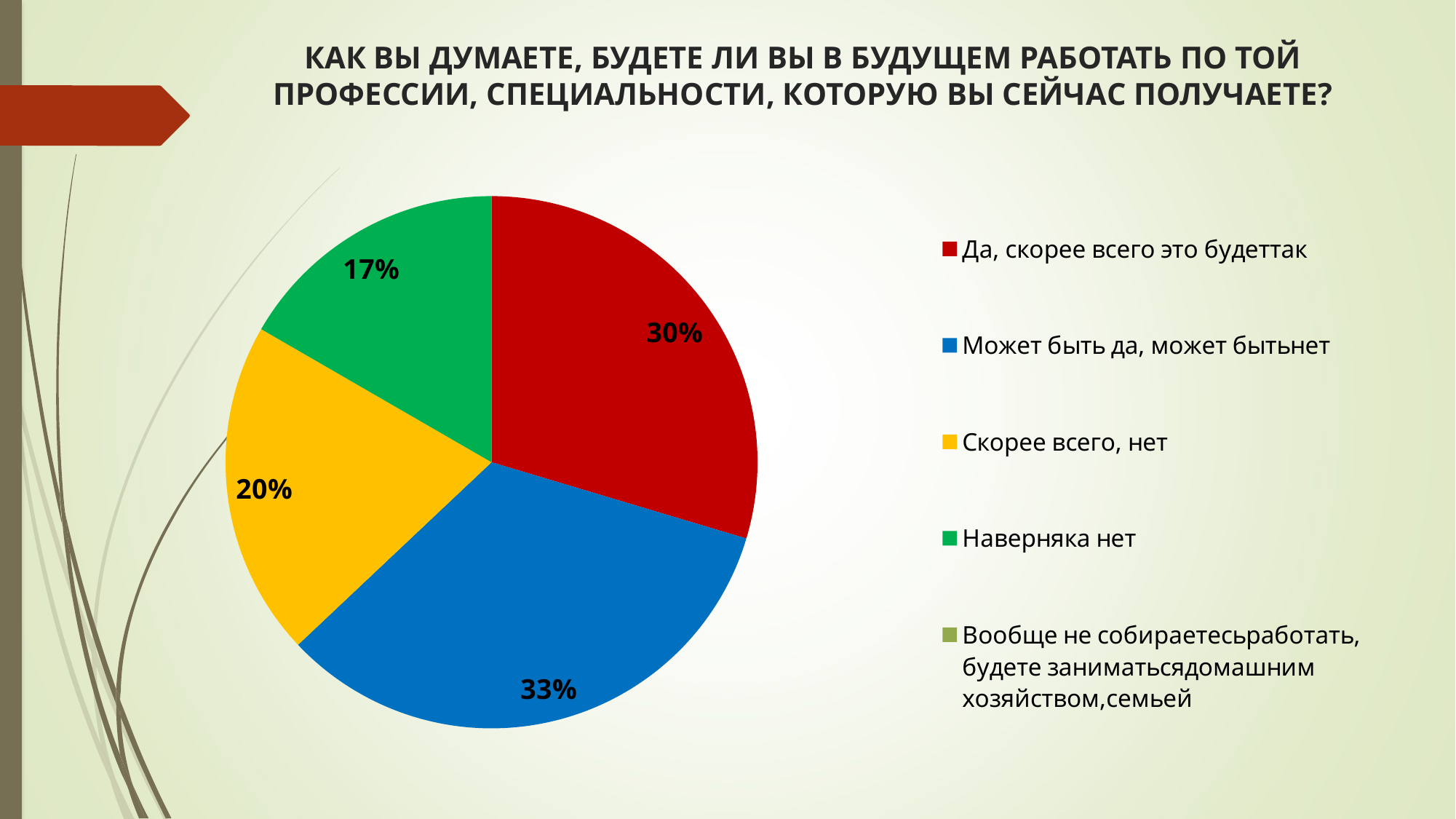
Which is larger: the "Да, скорее всего это будет так" slice or the "Скорее всего, нет" slice? Да, скорее всего это будет так What percentage is shown for "Наверняка нет"? 17% What value is labelled on the "Скорее всего, нет" slice? 20% Which labelled slice of the pie is the smallest? Наверняка нет What percentage is shown for the "Может быть да, может быть нет" slice? 33% By how many percentage points does the "Может быть да, может быть нет" slice exceed the "Да, скорее всего это будет так" slice? 3 percentage points What is the difference between the "Скорее всего, нет" and "Наверняка нет" slices? 3 percentage points Which response has the largest share of the pie? Может быть да, может быть нет What type of chart is shown on the slide? Pie chart How many entries does the legend list? 5 What percentage of the pie is the slice for "Да, скорее всего это будет так"? 30% How many slices with percentage labels are shown in the pie chart? 4